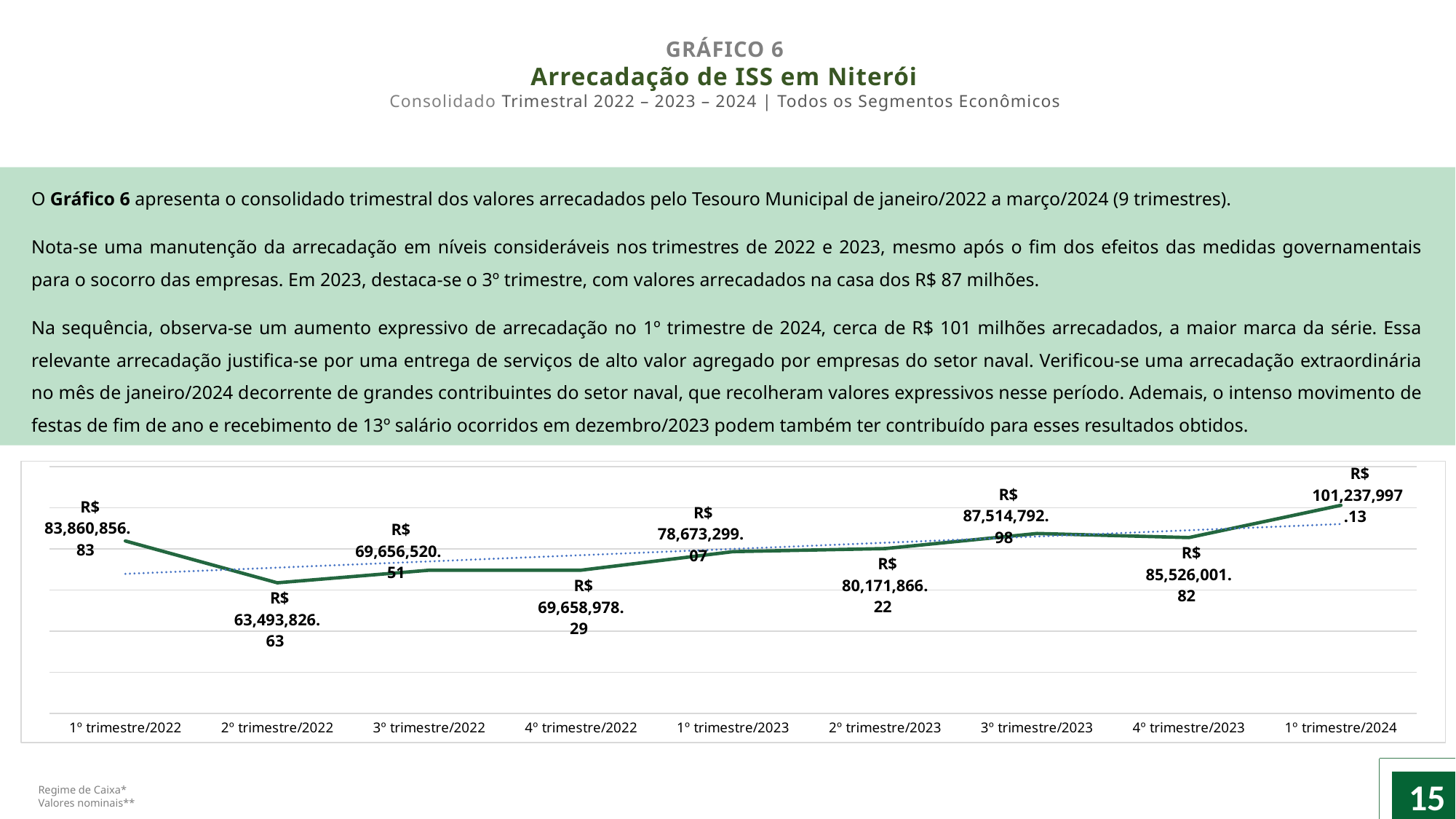
Which quarter has the highest value? 1º trimestre/2024 What is the difference between the values for 1º trimestre/2024 and 1º trimestre/2022? R$ 17,377,140.30 Which is larger, the value for 1º trimestre/2022 or the value for 2º trimestre/2023? 1º trimestre/2022 What is the value for 1º trimestre/2023? R$ 78,673,299.07 Which quarter has the lowest value? 2º trimestre/2022 What kind of chart is shown? Line chart What is the title of the chart? Arrecadação de ISS em Niterói What is the value for 1º trimestre/2024? R$ 101,237,997.13 What is the difference between the values for 3º trimestre/2023 and 4º trimestre/2023? R$ 1,988,791.16 What is the value for 2º trimestre/2022? R$ 63,493,826.63 How many quarters are plotted on the chart? 9 What is the value for 3º trimestre/2023? R$ 87,514,792.98